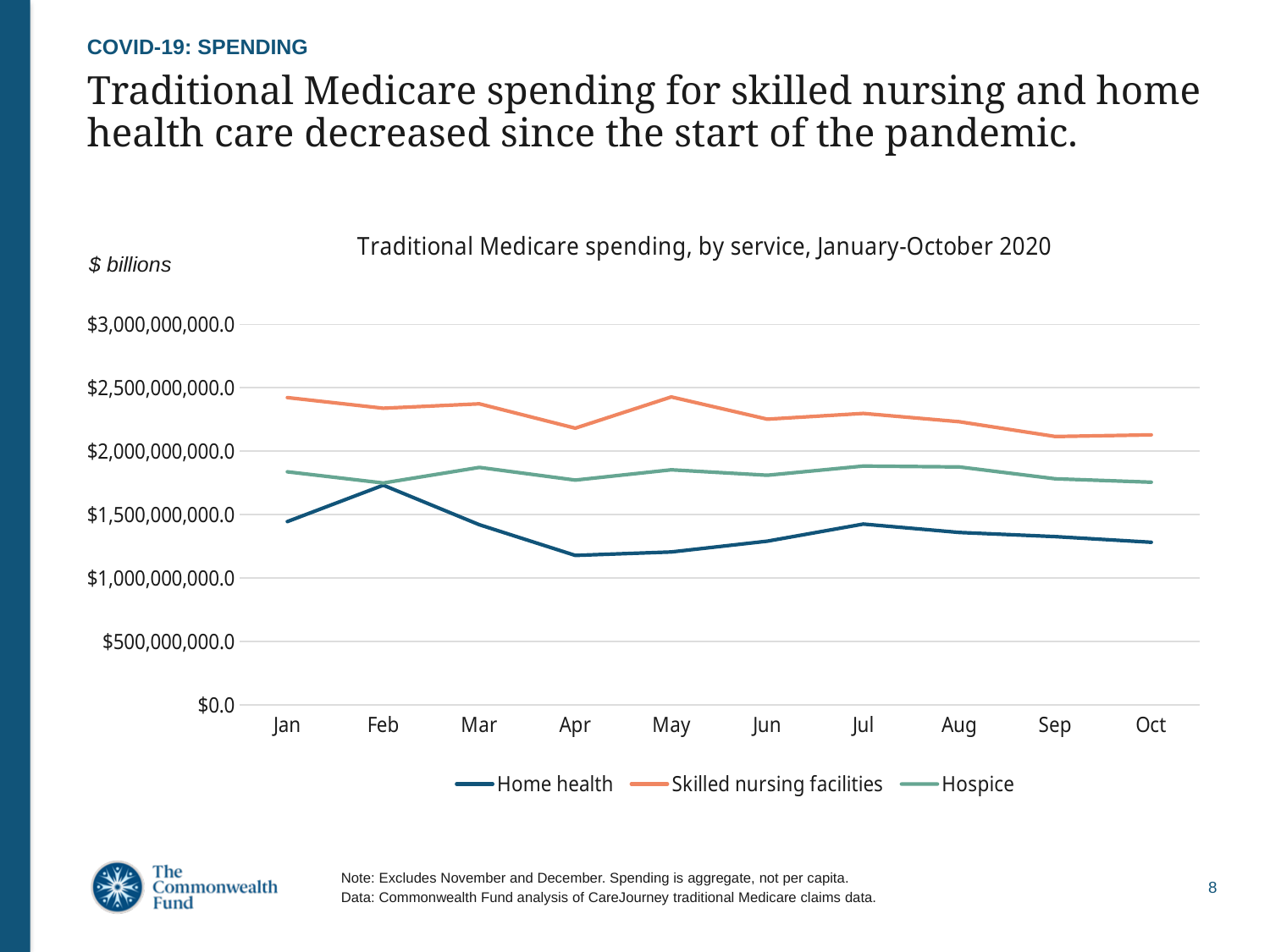
Is the Home health value for Apr greater or less than $1,500,000,000.0? less What kind of chart is shown on the slide? Line chart In which month is Home health spending highest? Feb Is the Skilled nursing facilities value for Jan greater or less than $2,500,000,000.0? less How many months are plotted along the x axis? 10 Which series has the highest spending in every month shown? Skilled nursing facilities Does Home health spending rise or fall from Feb to Apr? Fall Which is larger in Jan: Skilled nursing facilities spending or Hospice spending? Skilled nursing facilities What is the title of the chart? Traditional Medicare spending, by service, January-October 2020 How many series does the legend list? 3 Is the Home health value for Feb greater or less than $1,500,000,000.0? greater